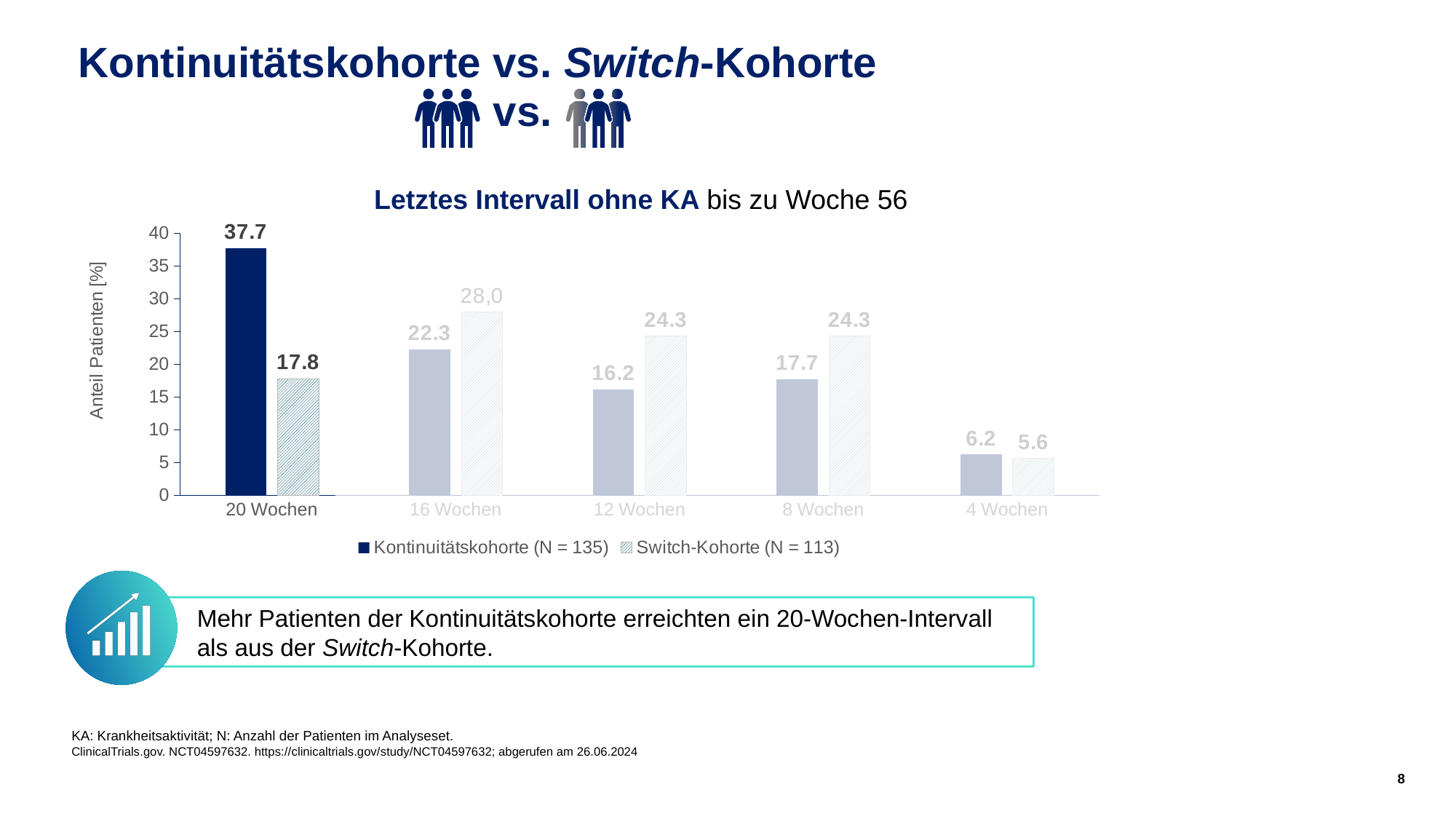
What is the label of the y axis? Anteil Patienten [%] At 12 Wochen, which series has the larger value, Kontinuitätskohorte or Switch-Kohorte? Switch-Kohorte Which category has the highest value for the Kontinuitätskohorte? 20 Wochen What is the value for the Switch-Kohorte at 16 Wochen? 28,0 What is the value for the Switch-Kohorte at 4 Wochen? 5.6 What is the value for the Kontinuitätskohorte at 8 Wochen? 17.7 Which category has the lowest value for the Switch-Kohorte? 4 Wochen What kind of chart is shown on the slide? Bar chart What is the value for the Kontinuitätskohorte at 20 Wochen? 37.7 How many categories are shown on the x axis? 5 What is the difference between the Kontinuitätskohorte and the Switch-Kohorte at 20 Wochen? 19.9 How many series does the legend list? 2